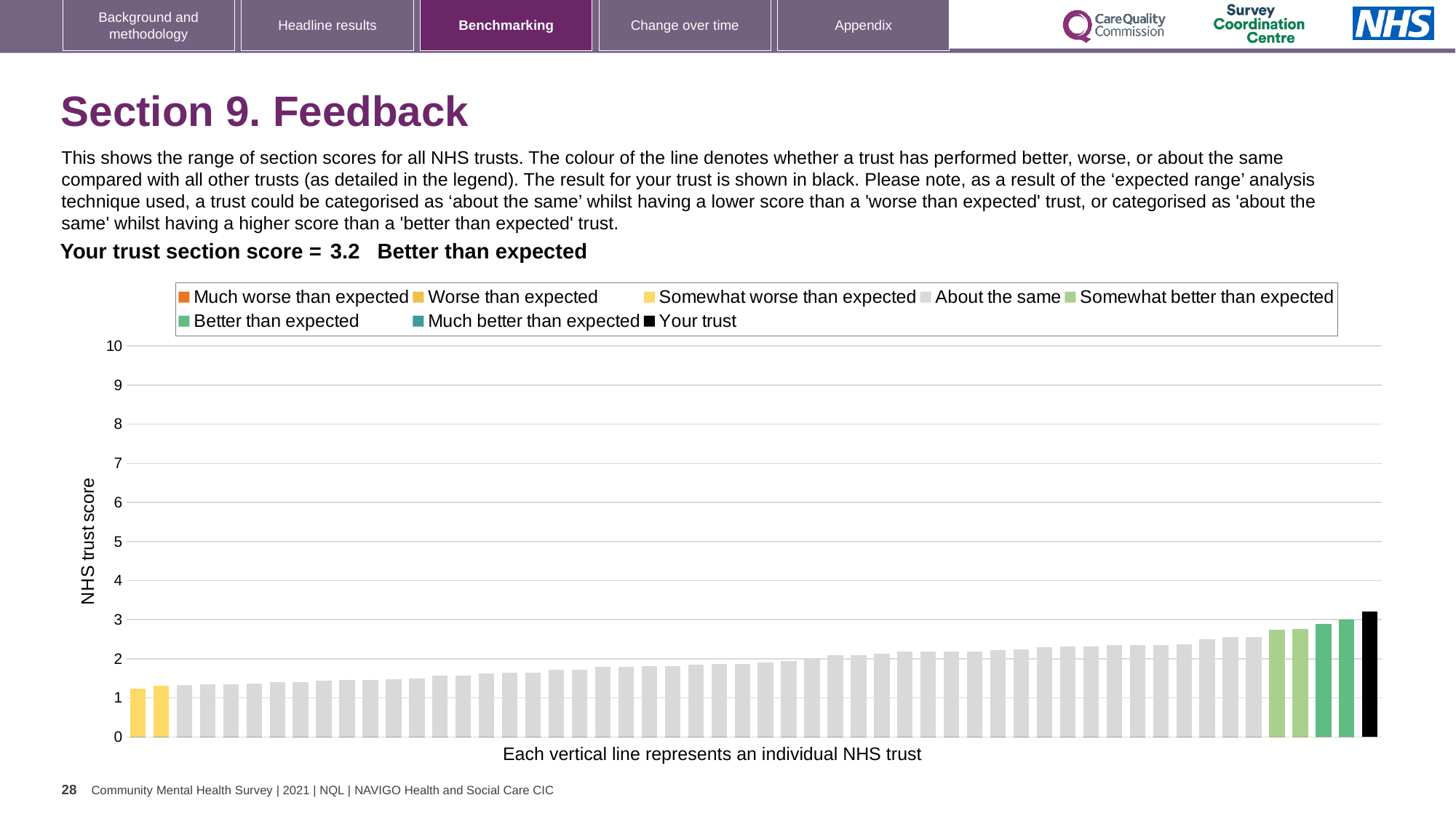
Which performance category is your trust placed in for this section? Better than expected What colour is the bar representing your trust? black Is the value of the black 'Your trust' bar greater or less than 3? greater Do the bar values rise or fall from left to right along the x axis? rise What is the section score for your trust shown on the slide? 3.2 What is the label on the vertical axis of the chart? NHS trust score What kind of chart is shown on the slide? bar chart Which legend category does the tallest bar in the chart belong to? Your trust How many entries does the chart legend list? 8 Are all the bars in the chart below the 4 gridline? yes Is the value of the lowest bar in the chart greater or less than 2? less